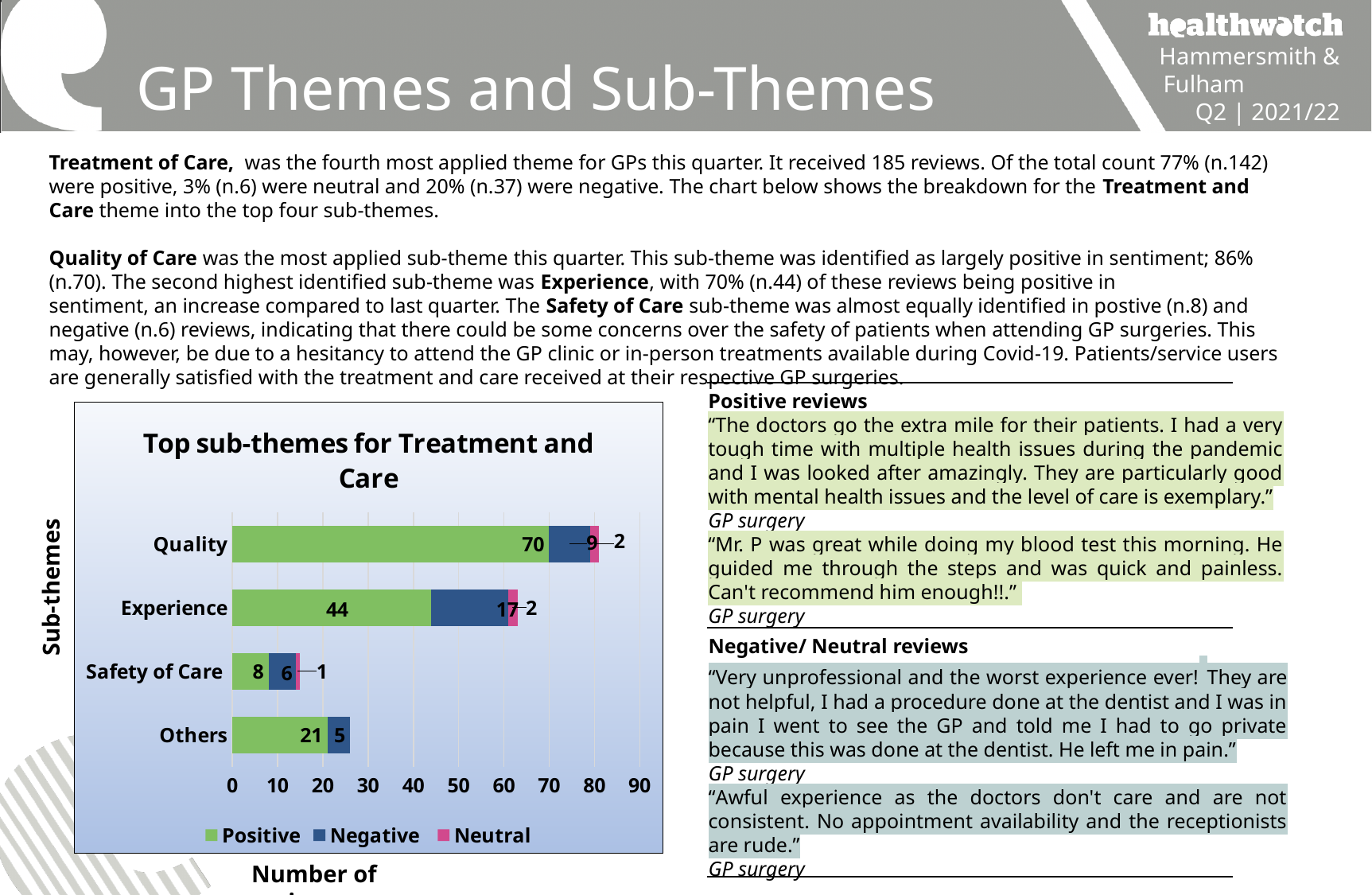
What is the Neutral value for Safety of Care? 1 Is the Negative value for Experience greater or less than the Negative value for Quality? greater What is the title of the chart? Top sub-themes for Treatment and Care What is the Positive value for Quality? 70 What is the total of the stacked bar for Experience? 63 Which sub-theme has the lowest Positive value? Safety of Care How many series does the chart legend list? 3 What is the difference between the Positive values for Quality and Experience? 26 What type of chart is shown on the slide? Stacked bar chart How many sub-theme categories are plotted on the chart? 4 Which sub-theme has the highest Positive value? Quality What is the Negative value for Experience? 17